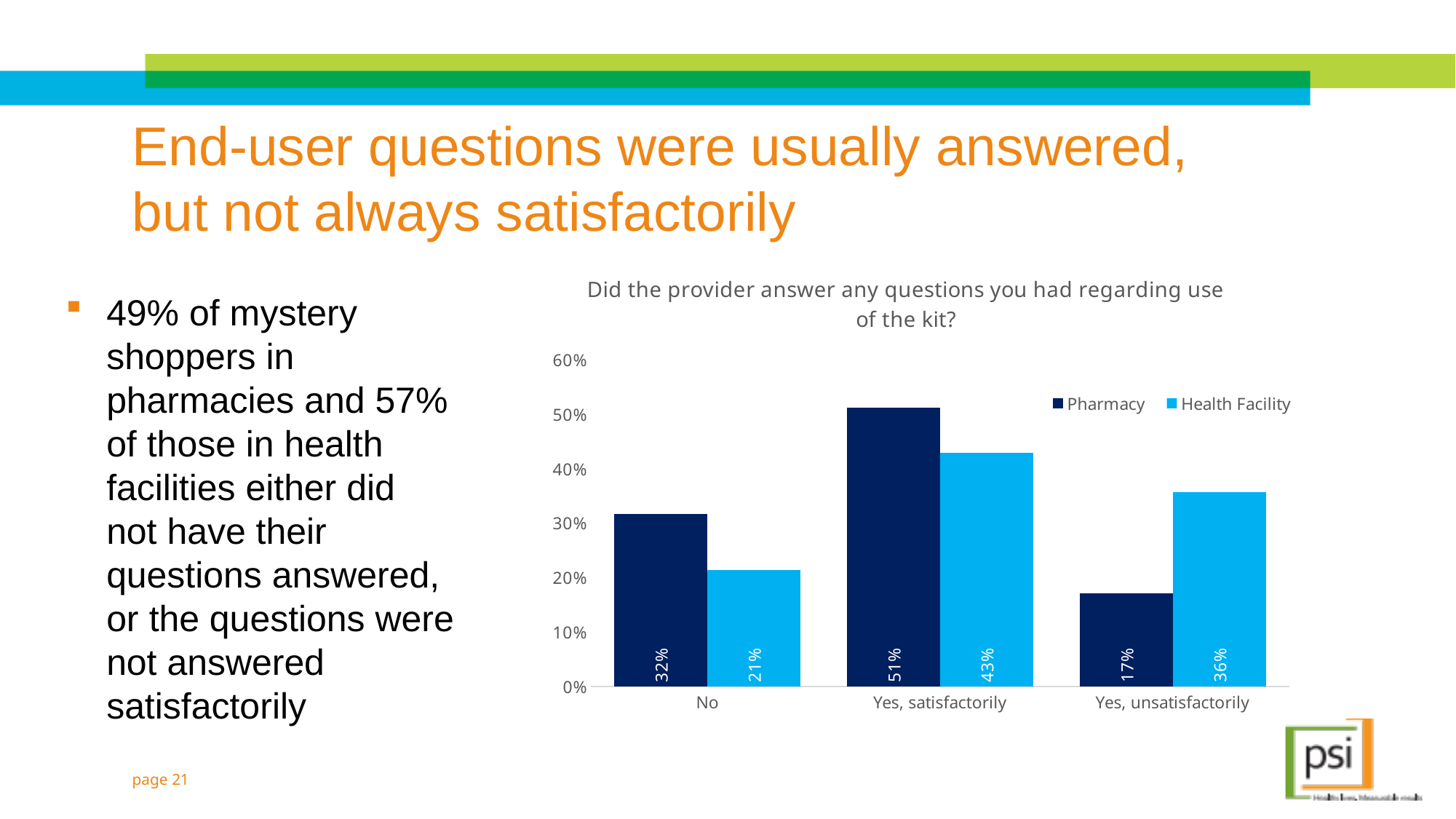
How many series does the legend list? 2 What is the Pharmacy value for "No"? 32% What kind of chart is shown on the slide? Bar chart Which is larger for "No": the Pharmacy value or the Health Facility value? Pharmacy Which category has the lowest Health Facility value? No Which category has the highest Pharmacy value? Yes, satisfactorily What is the Health Facility value for "No"? 21% What is the difference between the Pharmacy and Health Facility values for "Yes, unsatisfactorily"? 19% What is the Health Facility value for "Yes, satisfactorily"? 43% What is the Pharmacy value for "Yes, unsatisfactorily"? 17% How many categories are shown on the x axis? 3 Is the Health Facility value for "Yes, unsatisfactorily" greater or less than 30%? greater